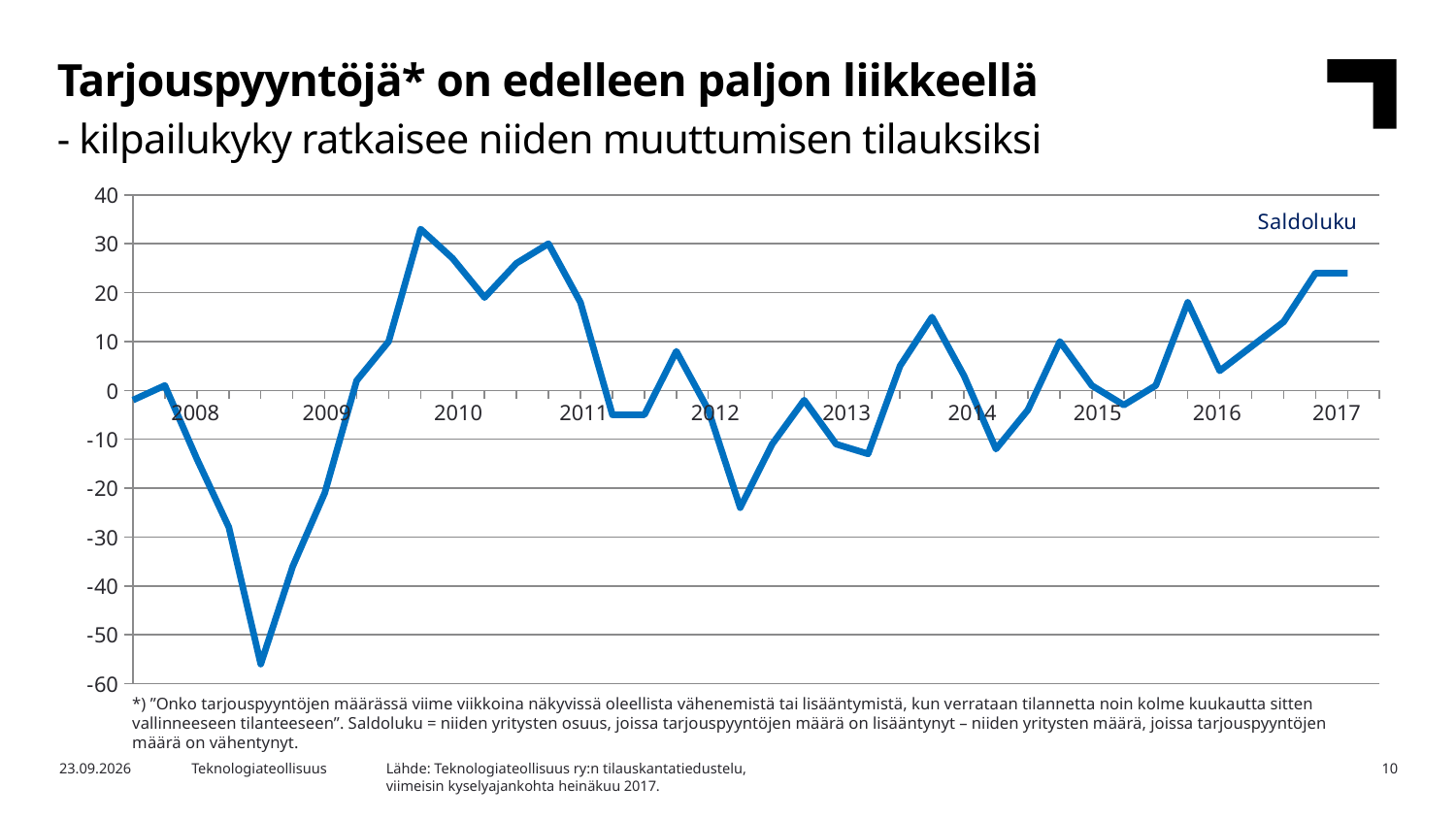
Does the line rise or fall between 2016 and 2017? rise Is the value at the 2013 label greater or less than 0? less What is the name of the series shown in the legend? Saldoluku Is the highest value on the line greater or less than 30? greater How many series does the legend list? 1 Does the line rise or fall from the start of 2008 to its lowest point? fall What is the highest value shown on the y axis? 40 Is the lowest value on the line greater or less than -50? less What kind of chart is shown on the slide? line chart How many year labels are shown on the x axis? 10